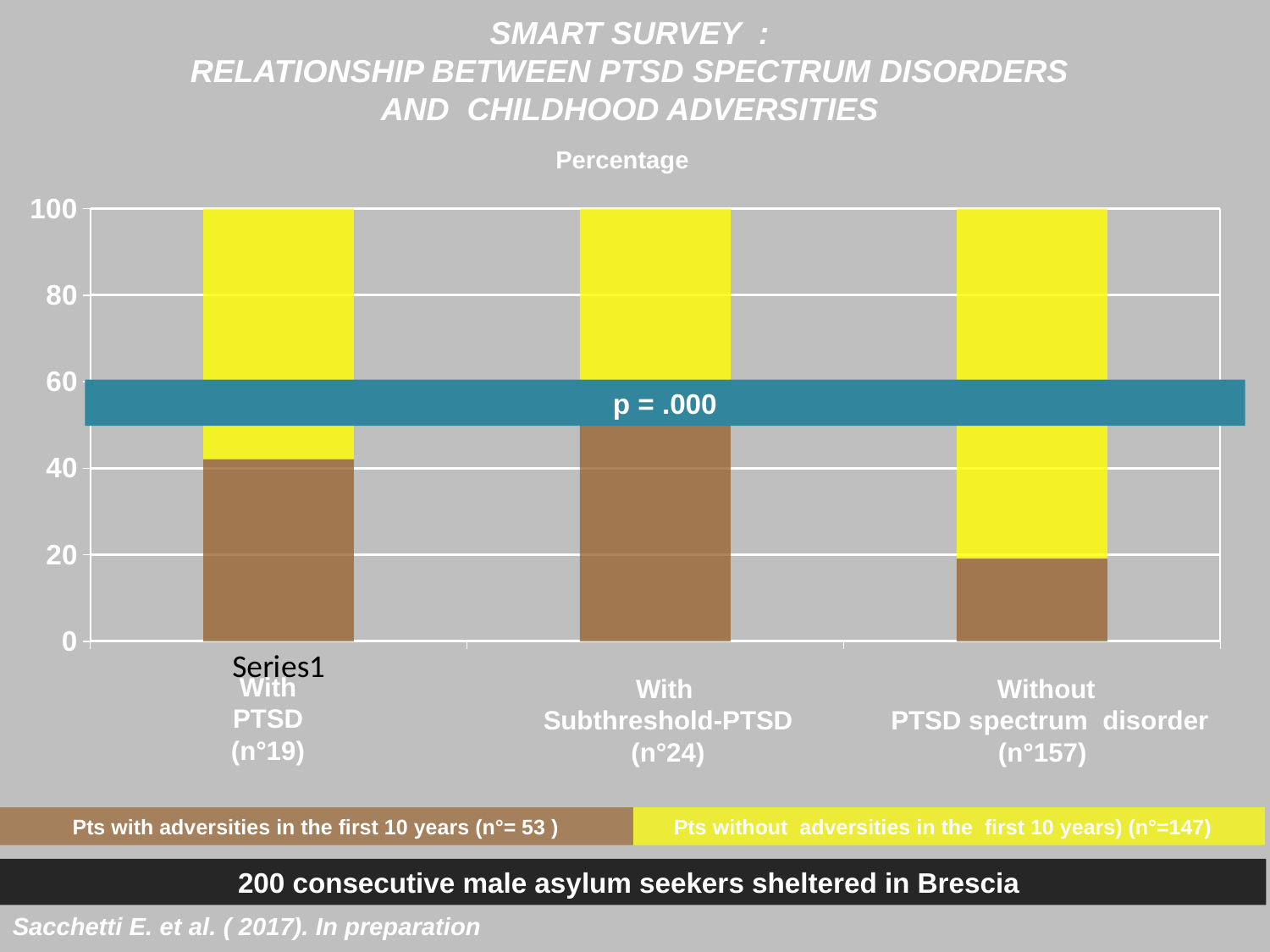
Which category has the largest yellow segment (Pts without adversities in the first 10 years)? Without PTSD spectrum disorder (n°157) How many series does the legend below the chart list? 2 Is the value of the brown segment (Pts with adversities) for With PTSD greater or less than 60? less Is the brown segment (Pts with adversities) for With PTSD larger or smaller than the brown segment for Without PTSD spectrum disorder? larger Is the value of the brown segment (Pts with adversities) for Without PTSD spectrum disorder greater or less than 40? less How many categories are shown on the x axis of the chart? 3 Which colour represents Pts with adversities in the first 10 years? brown What kind of chart is shown on the slide? bar chart Is the value of the brown segment (Pts with adversities) for With Subthreshold-PTSD greater or less than 40? greater What p value is printed across the chart? p = .000 Which category has the smallest brown segment (Pts with adversities in the first 10 years)? Without PTSD spectrum disorder (n°157) Which category has the largest brown segment (Pts with adversities in the first 10 years)? With Subthreshold-PTSD (n°24)